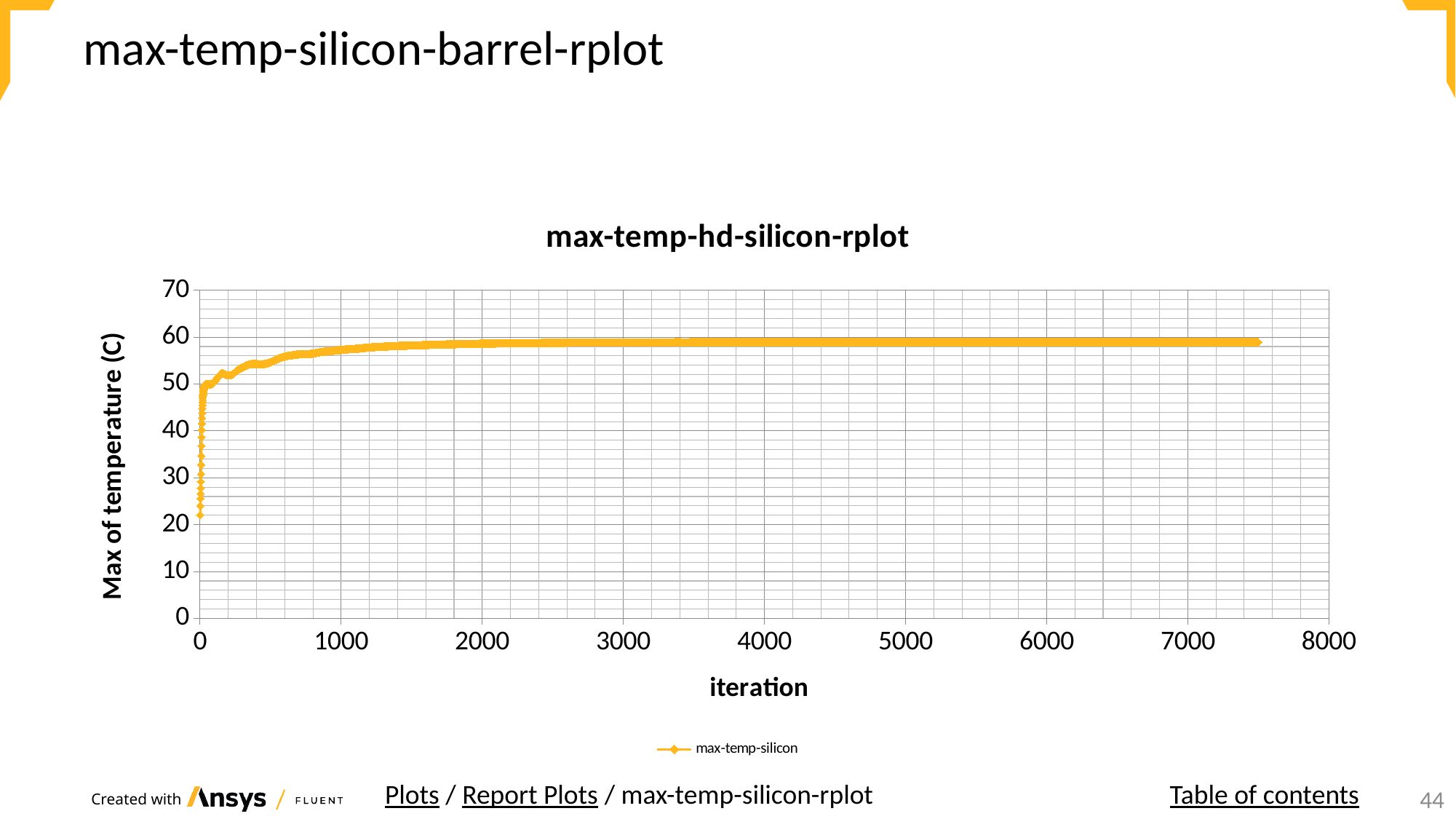
Is the value for max-temp-silicon at iteration 6000 greater or less than 30? greater How many series does the legend list? 1 Is the value for max-temp-silicon at iteration 7000 greater or less than 40? greater Does the plotted temperature rise or fall as the iteration count increases? rise Is the value for max-temp-silicon at iteration 1000 greater or less than 60? less What is the label of the y axis? Max of temperature (C) What is the title of the chart? max-temp-hd-silicon-rplot What kind of chart is shown on the slide? line chart Which is larger, the value for max-temp-silicon at iteration 100 or at iteration 5000? iteration 5000